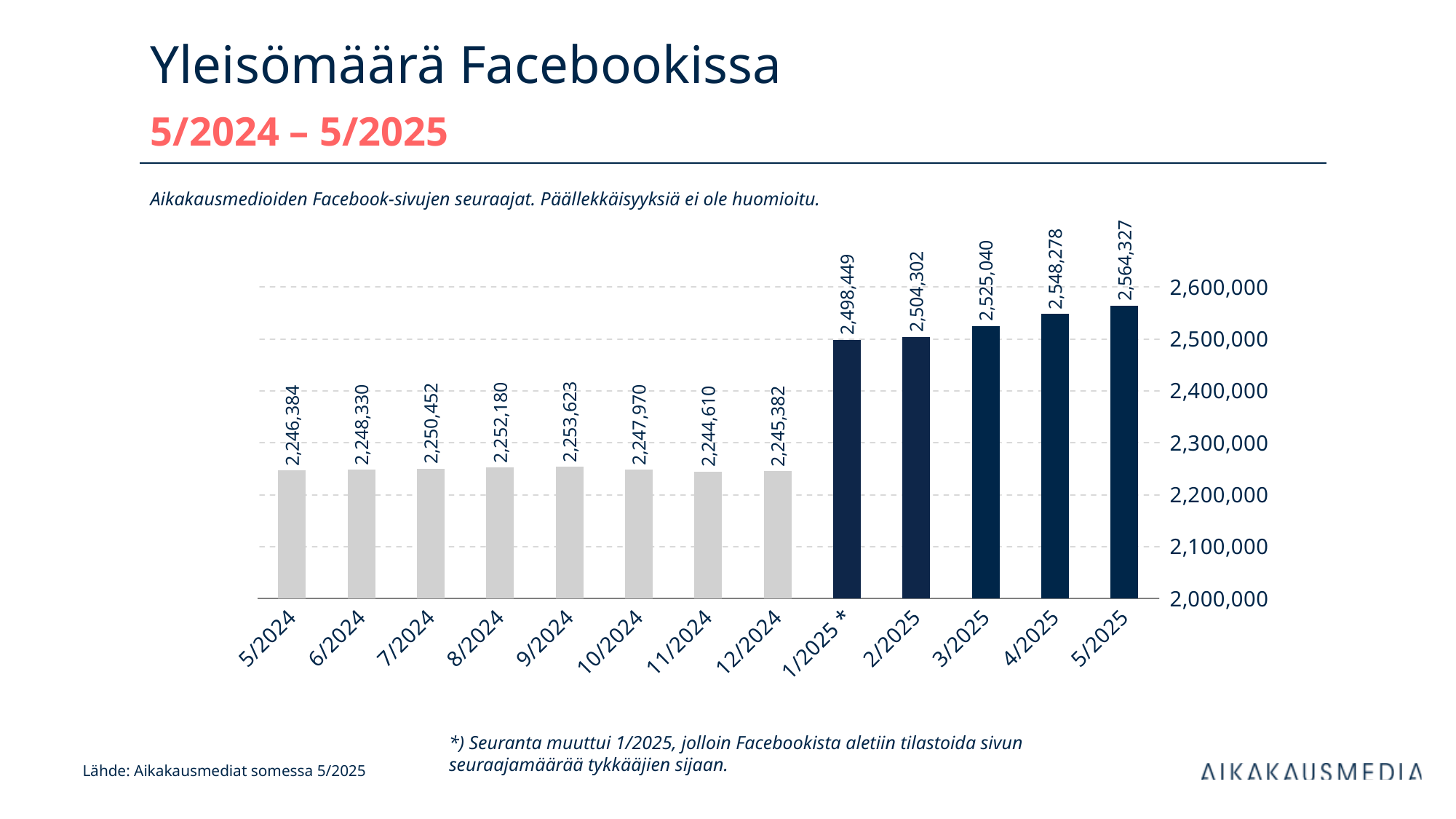
Which month has the highest value? 5/2025 Is the value for 3/2025 greater or less than 2,500,000? greater Which month has the lowest value? 11/2024 How many months are shown on the chart? 13 What is the value for 5/2025? 2,564,327 What is the difference between the values for 1/2025 * and 12/2024? 253,067 Do the values rise or fall from 1/2025 * to 5/2025? rise What is the value for 9/2024? 2,253,623 What is the value for 1/2025 *? 2,498,449 Which is larger, the value for 8/2024 or the value for 10/2024? 8/2024 What kind of chart is shown on the slide? bar chart What is the difference between the values for 5/2025 and 5/2024? 317,943